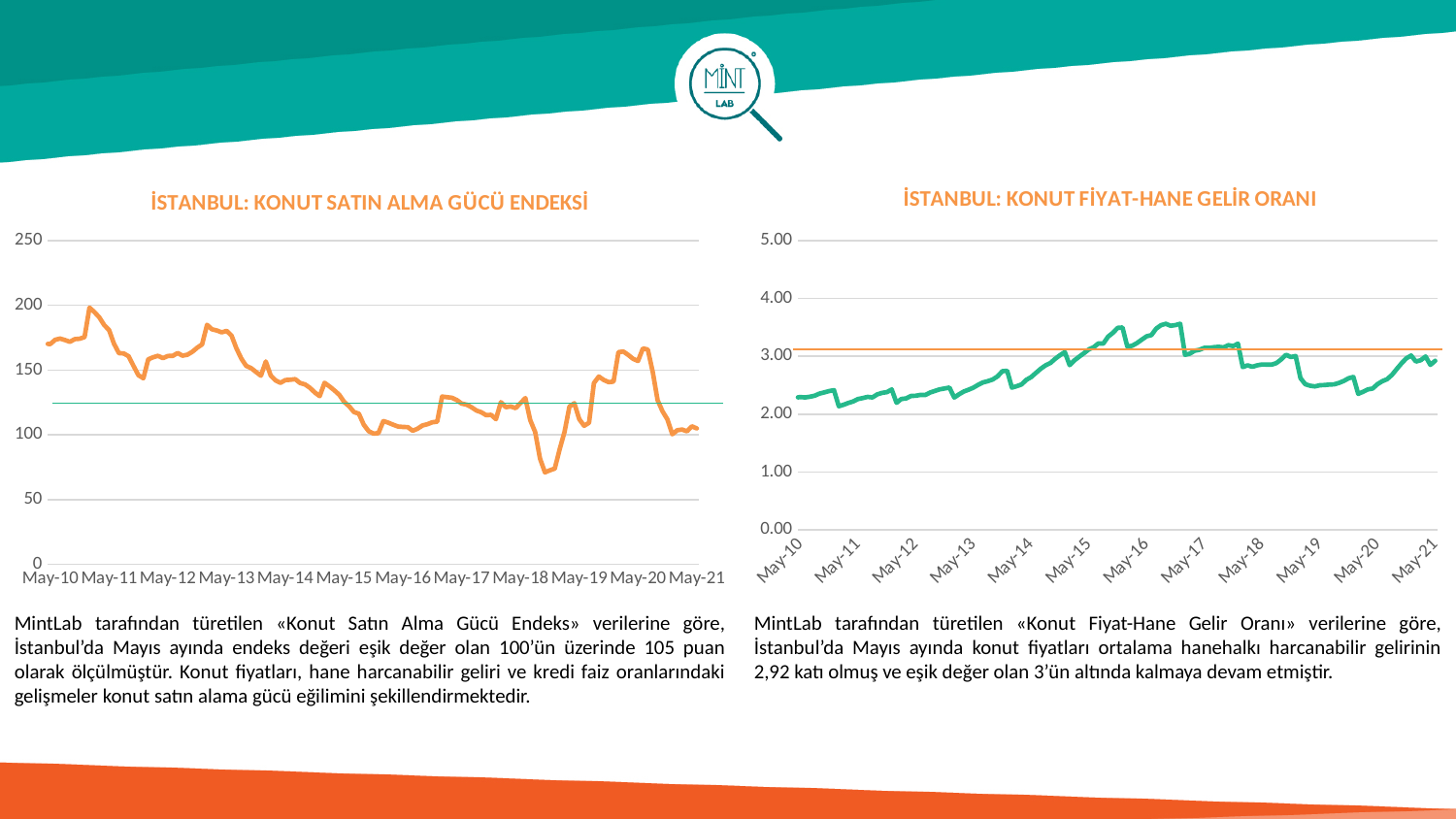
In the left chart (Konut Satın Alma Gücü Endeksi), is the lowest point of the line greater or less than 100? less In the left chart (Konut Satın Alma Gücü Endeksi), does the line end higher or lower at May-21 than it starts at May-10? lower In the left chart (Konut Satın Alma Gücü Endeksi), is the value at May-10 greater or less than 150? greater In the right chart (Konut Fiyat-Hane Gelir Oranı), is the value at May-21 greater or less than 2.00? greater What kind of chart is the 'İSTANBUL: KONUT FİYAT-HANE GELİR ORANI' chart on the right? Line chart How many year labels are shown on the x axis of the left chart (Konut Satın Alma Gücü Endeksi)? 12 In the right chart (Konut Fiyat-Hane Gelir Oranı), does the line end higher or lower at May-21 than it starts at May-10? higher What colour is the data line in the right chart (Konut Fiyat-Hane Gelir Oranı)? Green What kind of chart is the 'İSTANBUL: KONUT SATIN ALMA GÜCÜ ENDEKSİ' chart on the left? Line chart